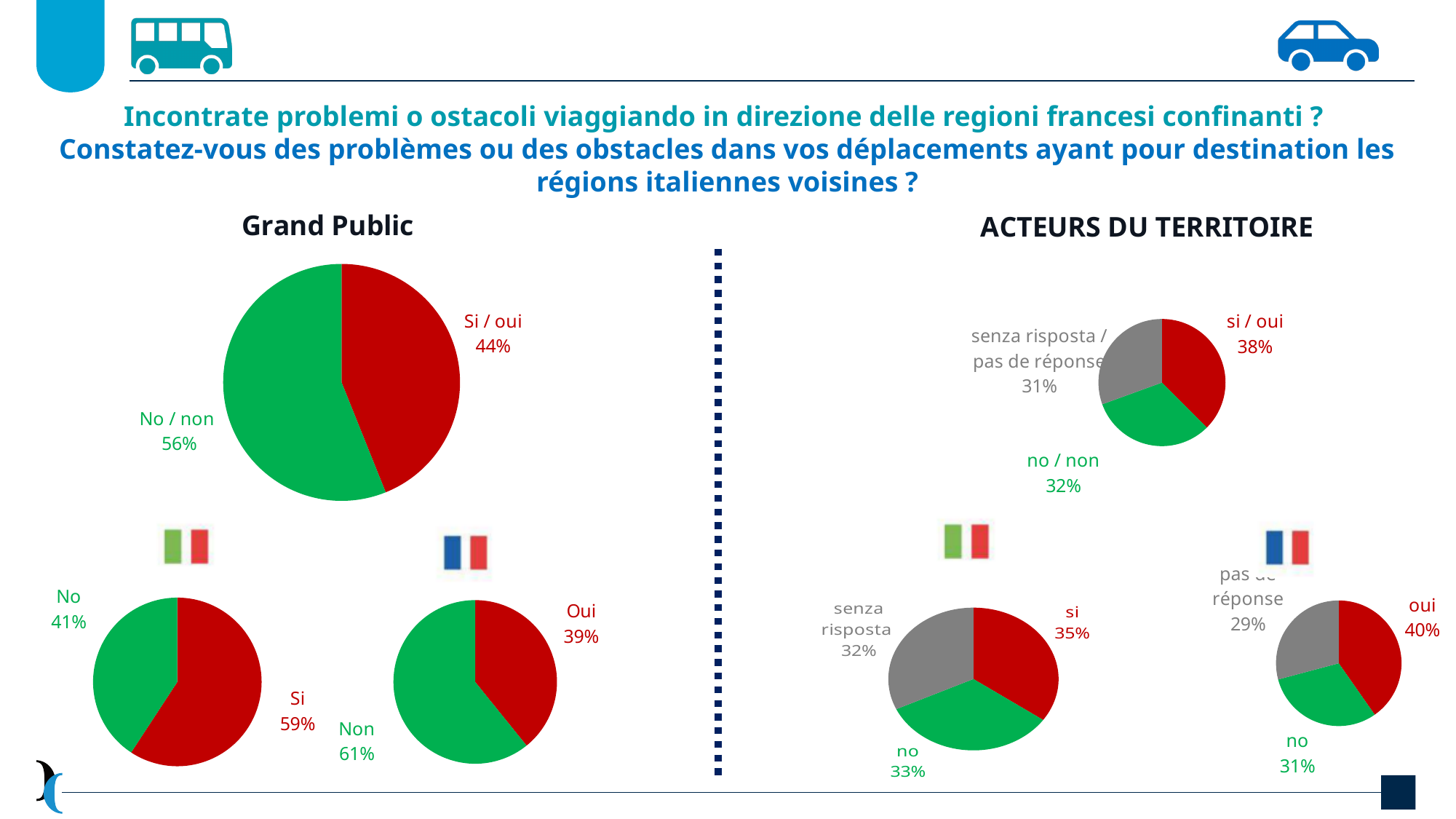
In the top pie chart under 'Grand Public', what share is labelled 'Si / oui'? 44% In the top pie chart under 'Grand Public', which slice is larger, 'Si / oui' or 'No / non'? No / non In the bottom-right pie chart under 'Grand Public' (French flag), what is the difference between the 'Non' and 'Oui' shares? 22% In the bottom-right pie chart under 'Grand Public' (French flag), what share is labelled 'Non'? 61% In the top pie chart under 'ACTEURS DU TERRITOIRE', how many slices does the pie have? 3 In the bottom-right pie chart under 'ACTEURS DU TERRITOIRE' (French flag), which slice is the largest? oui In the bottom-left pie chart under 'Grand Public' (Italian flag), what share is labelled 'Si'? 59% In the bottom-left pie chart under 'ACTEURS DU TERRITOIRE' (Italian flag), what share is labelled 'senza risposta'? 32% In the bottom-right pie chart under 'ACTEURS DU TERRITOIRE' (French flag), what share is labelled 'no'? 31% What type of chart is used throughout this slide? Pie chart In the top pie chart under 'Grand Public', what share is labelled 'No / non'? 56% In the top pie chart under 'ACTEURS DU TERRITOIRE', what share is labelled 'si / oui'? 38%